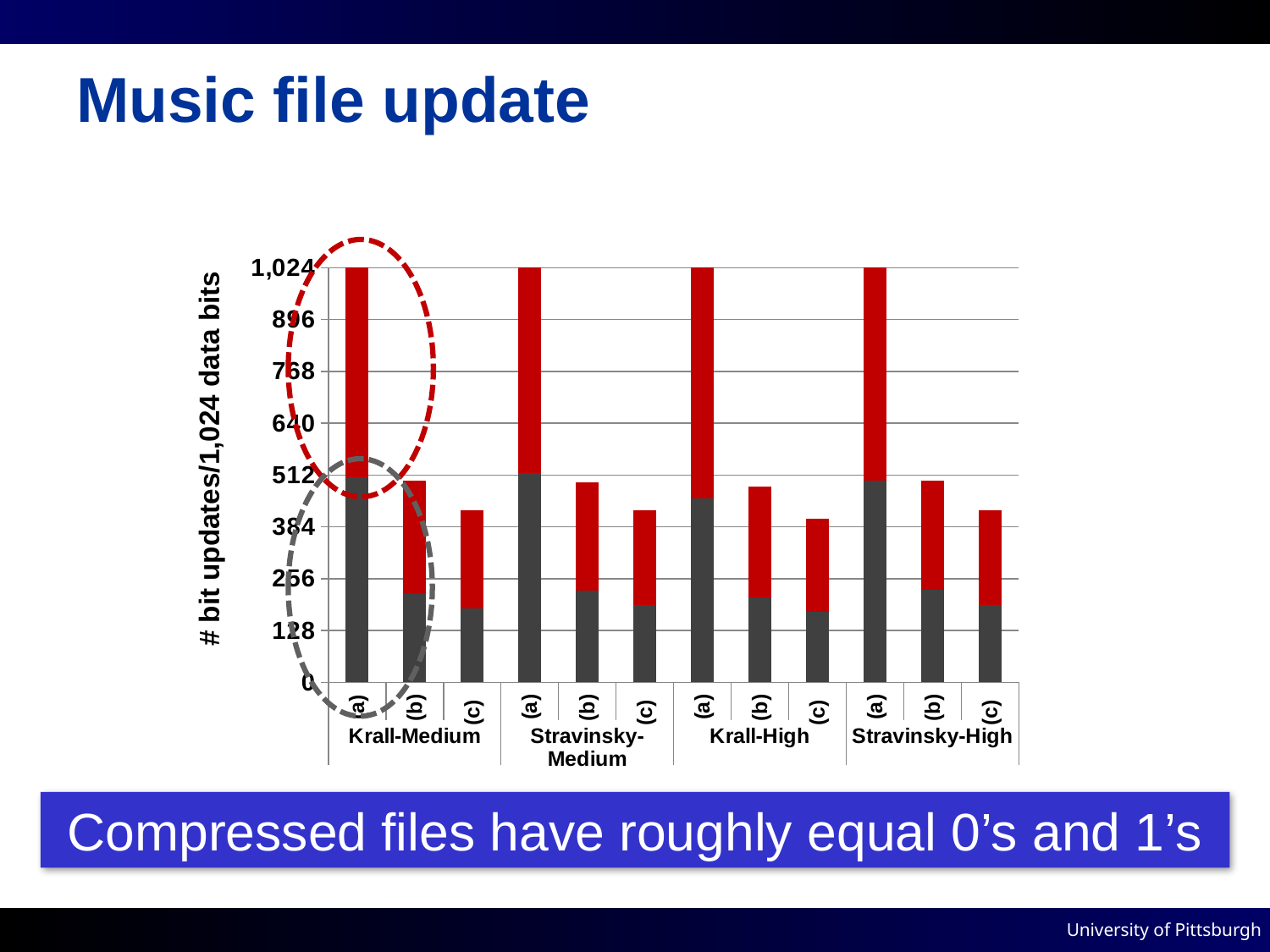
What is the label of the y axis? # bit updates/1,024 data bits What kind of chart is shown on the slide? bar chart Which is taller, the Krall-Medium (a) bar or the Krall-Medium (b) bar? Krall-Medium (a) How many music file groups are labelled along the x axis? 4 Is the total for Krall-Medium (c) greater or less than 512? less Is the total for Stravinsky-Medium (a) greater or less than 896? greater Within each group, do the bar totals rise or fall from (a) to (c)? fall Within the Krall-High group, which bar is the tallest? (a) How many bars are plotted in the chart? 12 Is the dark grey portion of the Krall-Medium (b) bar greater or less than 256? less Within the Stravinsky-High group, which bar is the shortest? (c) What is the total height of the Krall-Medium (a) bar? 1,024